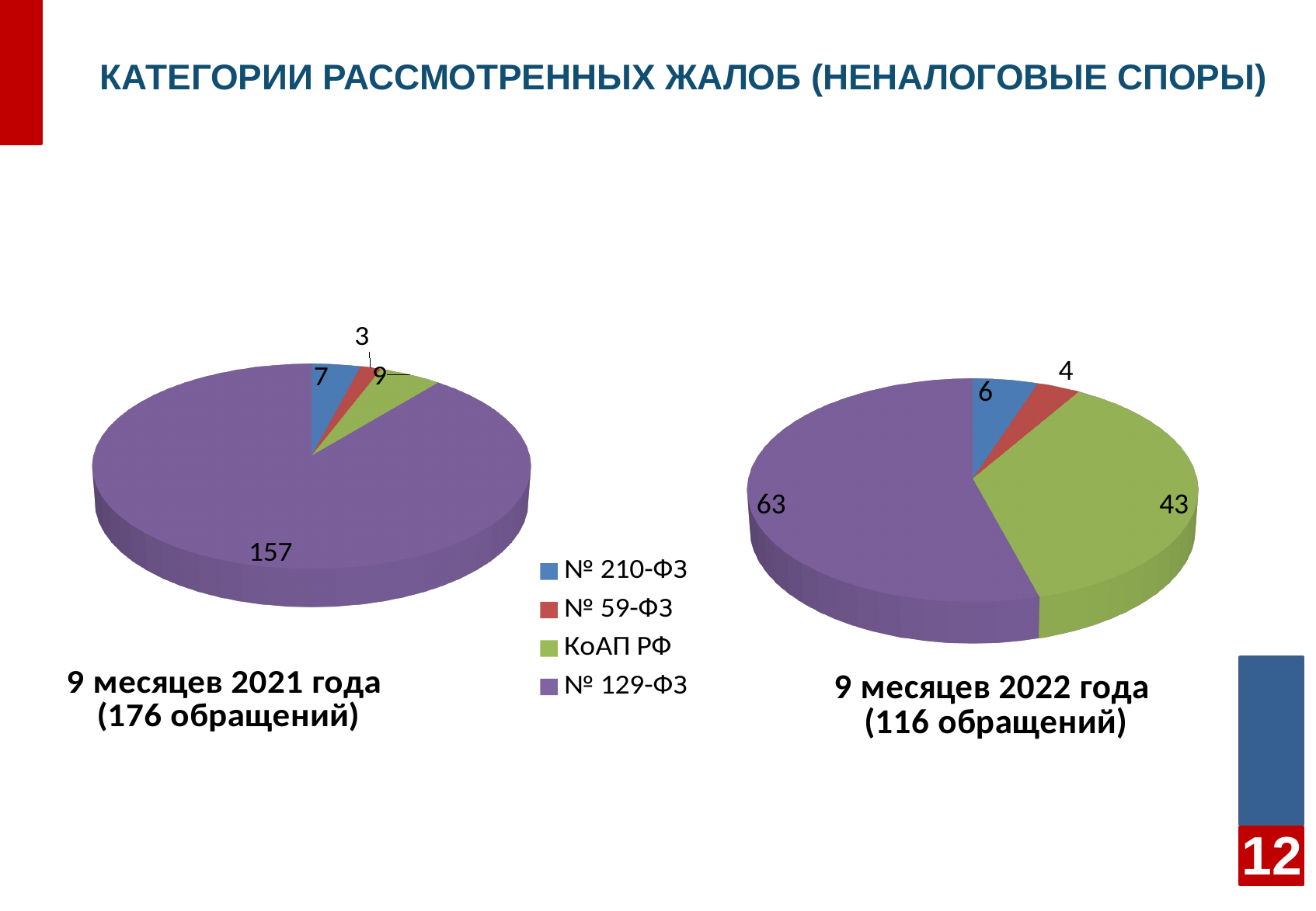
How many slices does the left pie chart (9 месяцев 2021 года) have? 4 Which colour represents № 129-ФЗ in the legend? purple In the left pie chart (9 месяцев 2021 года), which category has the smallest value? № 59-ФЗ In the right pie chart (9 месяцев 2022 года), what is the value for № 59-ФЗ? 4 What is the total of all slices in the right pie chart (9 месяцев 2022 года)? 116 In the left pie chart (9 месяцев 2021 года), which is larger: КоАП РФ or № 210-ФЗ? КоАП РФ In the right pie chart (9 месяцев 2022 года), which category has the largest value? № 129-ФЗ In the left pie chart (9 месяцев 2021 года), what is the value for № 129-ФЗ? 157 How many entries does the legend list? 4 What kind of chart is the right chart (9 месяцев 2022 года)? pie chart In the right pie chart (9 месяцев 2022 года), what is the value for КоАП РФ? 43 In the right pie chart (9 месяцев 2022 года), what is the difference between № 129-ФЗ and КоАП РФ? 20